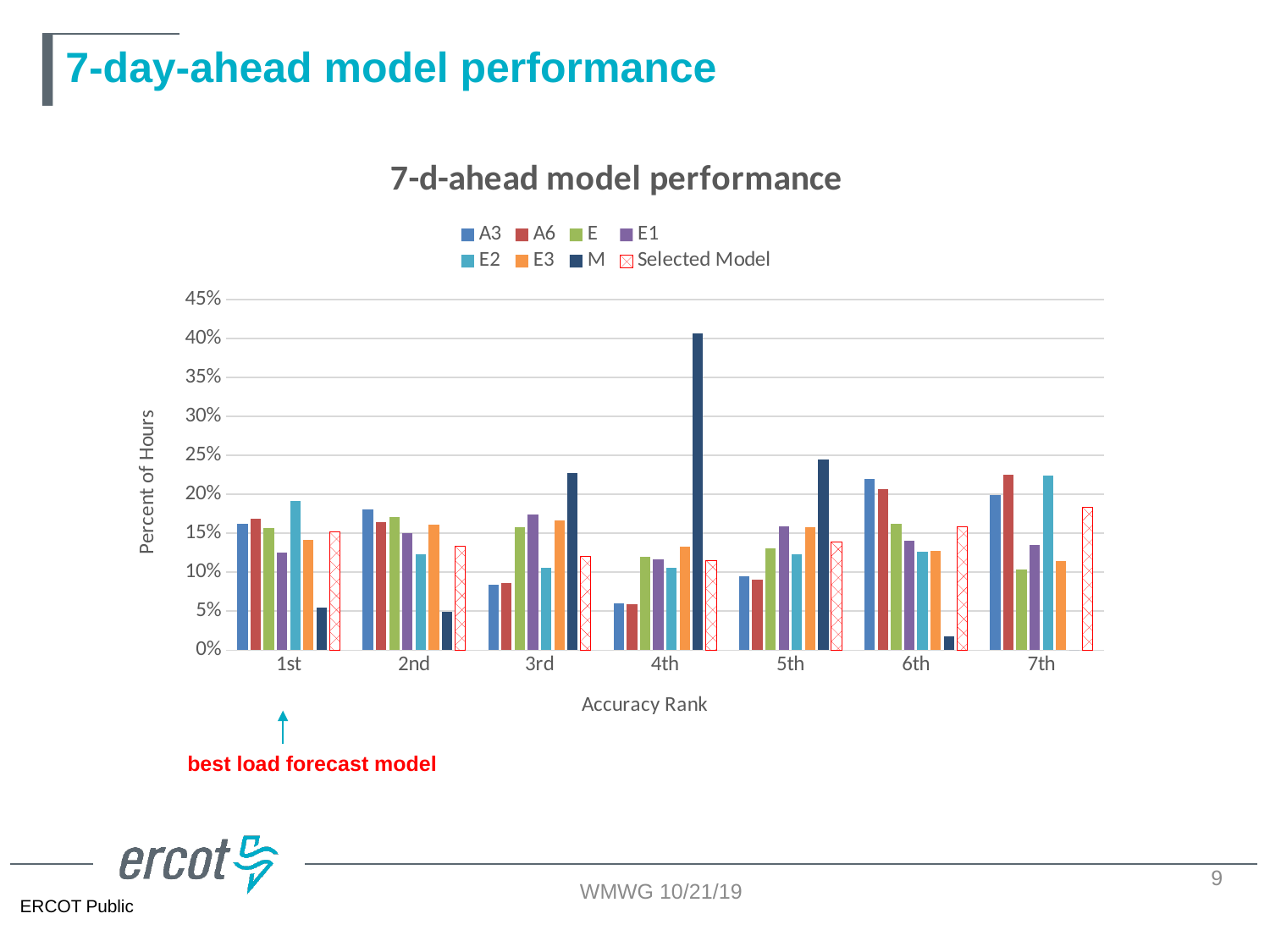
At the 7th accuracy rank, which is larger: E1 or E? E1 Which model has the lowest value at the 6th accuracy rank? M At the 1st accuracy rank, which is larger: E2 or M? E2 Is the value for M at the 4th accuracy rank greater or less than 35%? greater Which model has the highest value at the 1st accuracy rank? E2 Is the value for A3 at the 6th accuracy rank greater or less than 20%? greater What is the title of the y axis? Percent of Hours How many series does the legend list? 8 Which model has the highest value at the 4th accuracy rank? M Is the value for M at the 1st accuracy rank greater or less than 10%? less How many accuracy rank categories are shown on the x axis? 7 What kind of chart is shown on the slide? bar chart